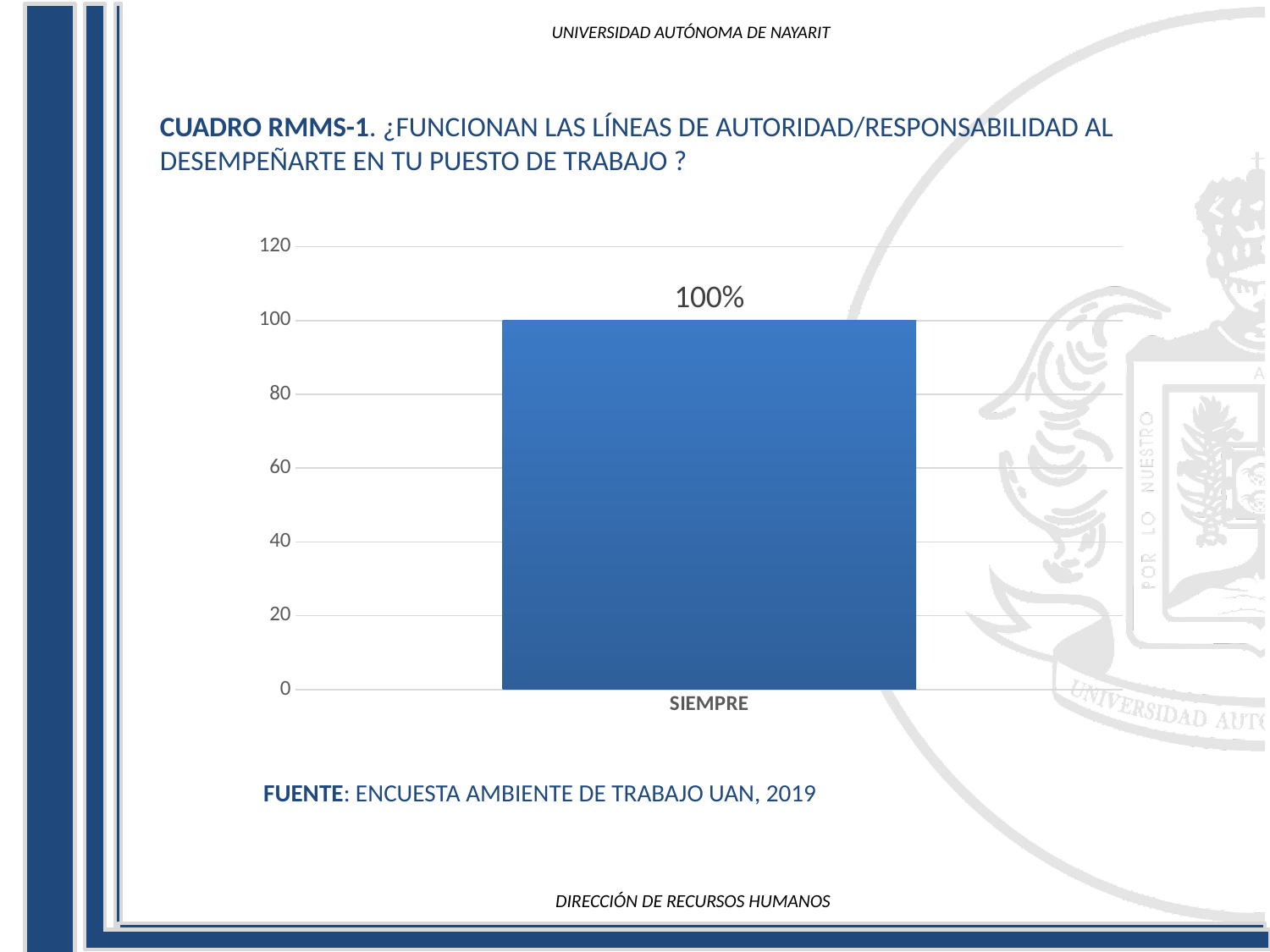
What is the value shown for SIEMPRE? 100% How many categories are plotted on the x axis? 1 Is the value for SIEMPRE greater or less than 80? greater What is the highest value shown on the y axis? 120 Which category has the highest value? SIEMPRE What kind of chart is shown on the slide? bar chart Is the value for SIEMPRE greater or less than 120? less What is the label of the only category on the x axis? SIEMPRE